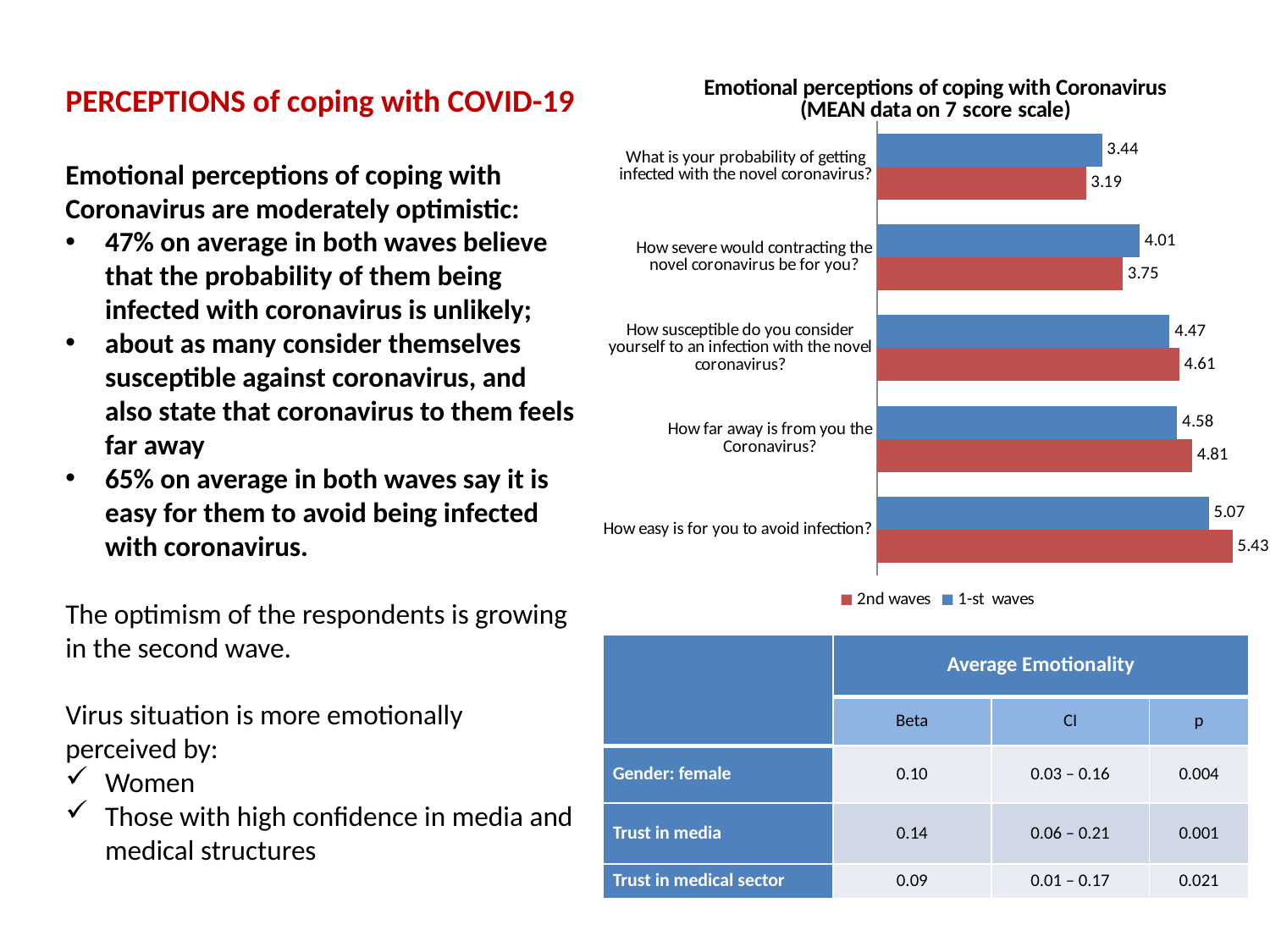
Which question has the highest 2nd waves value? How easy is for you to avoid infection? What is the difference between the 1-st waves and 2nd waves values for "How severe would contracting the novel coronavirus be for you?"? 0.26 What type of chart is shown on the slide? Bar chart What is the 2nd waves value for "What is your probability of getting infected with the novel coronavirus?"? 3.19 Which question has the lowest 1-st waves value? What is your probability of getting infected with the novel coronavirus? How many series does the chart legend list? 2 How many questions (categories) are shown in the chart? 5 What is the 2nd waves value for "How far away is from you the Coronavirus?"? 4.81 For "How susceptible do you consider yourself to an infection with the novel coronavirus?", which is larger: the 1-st waves value or the 2nd waves value? 2nd waves What is the 1-st waves value for "How easy is for you to avoid infection?"? 5.07 What is the difference between the 2nd waves and 1-st waves values for "How easy is for you to avoid infection?"? 0.36 What is the title of the chart? Emotional perceptions of coping with Coronavirus (MEAN data on 7 score scale)